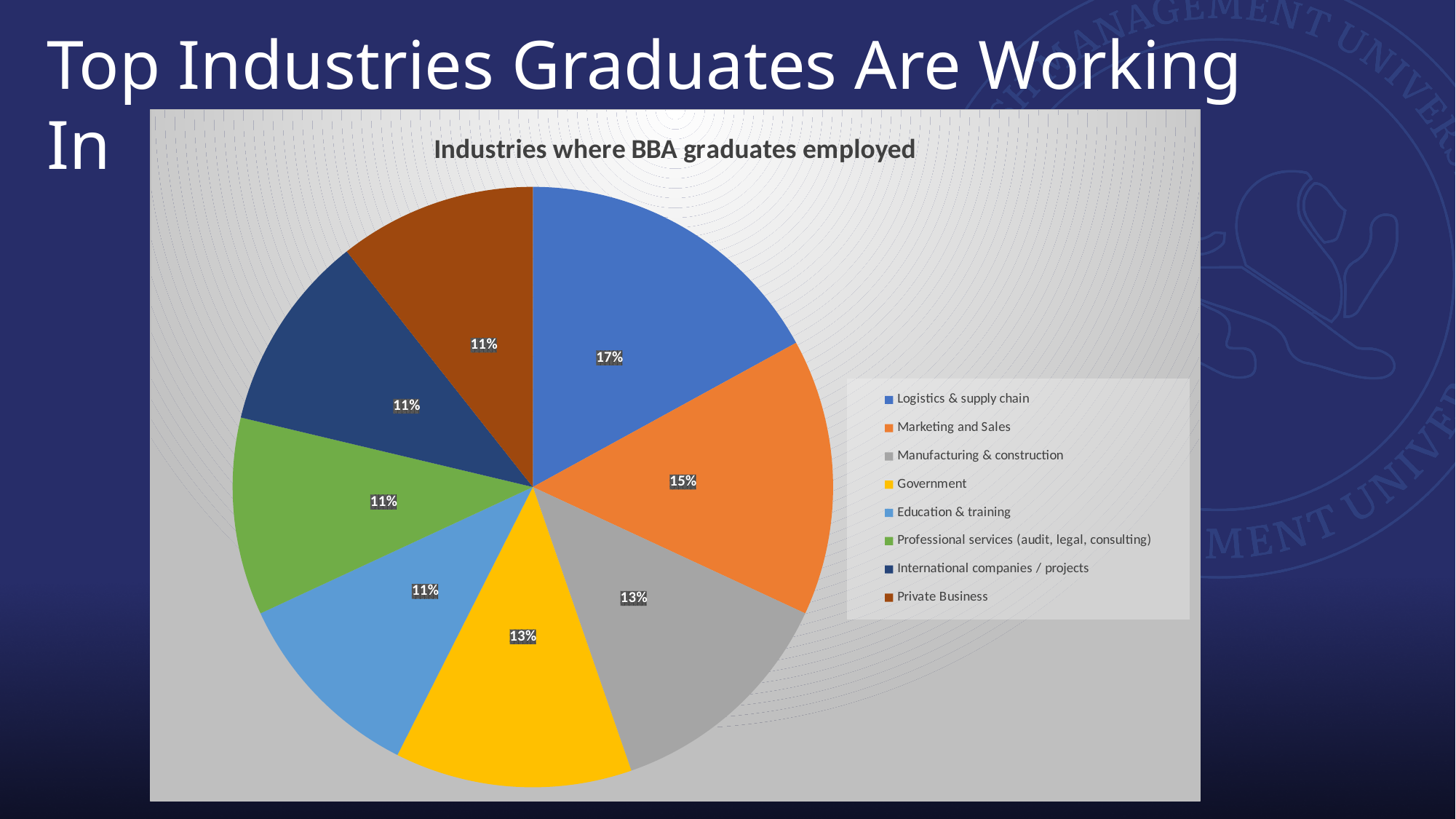
Which is larger, the share for Logistics & supply chain or the share for Marketing and Sales? Logistics & supply chain Which colour represents Government in the legend? Yellow What share does Government represent in the chart? 13% What is the title of the chart? Industries where BBA graduates employed Which industry has the largest share of the pie? Logistics & supply chain What percentage is shown for Private Business? 11% What is the difference between the Logistics & supply chain share and the Marketing and Sales share? 2 percentage points What is the value shown for Education & training? 11% What share of BBA graduates are employed in Logistics & supply chain? 17% What percentage of the pie is Marketing and Sales? 15% What type of chart is shown on the slide? Pie chart How many industries (slices) are shown in the pie chart? 8